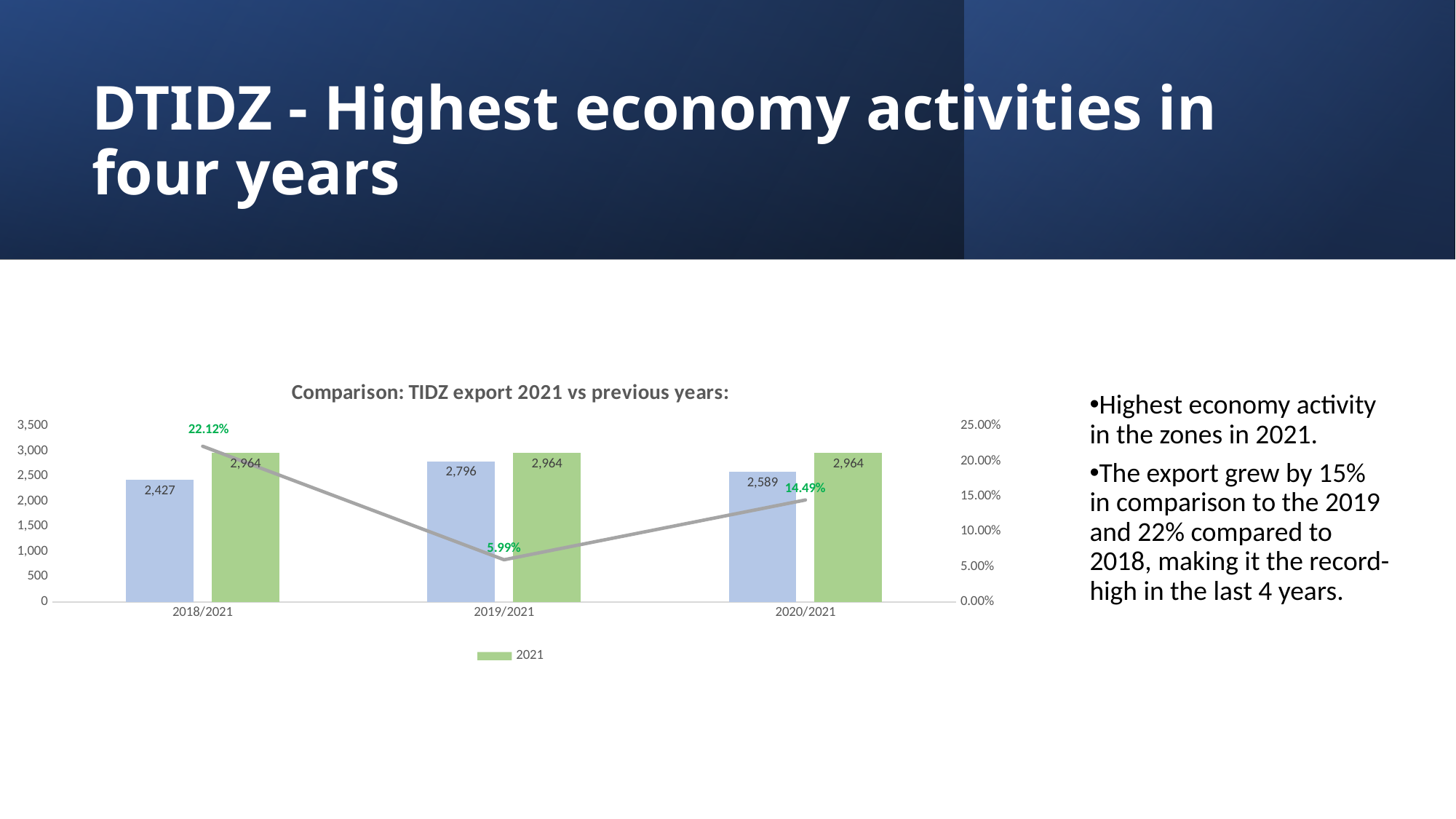
What is the title of the chart? Comparison: TIDZ export 2021 vs previous years: What is the value of the blue bar for 2018/2021? 2,427 What is the difference between the green 2021 bar and the blue bar for 2018/2021? 537 What percentage does the line show for 2019/2021? 5.99% What is the value of the green 2021 bar for 2019/2021? 2,964 What percentage does the line show for 2018/2021? 22.12% Which category has the lowest percentage on the line? 2019/2021 Which category has the highest blue bar value? 2019/2021 What percentage does the line show for 2020/2021? 14.49% How many categories are shown on the x axis? 3 What is the value of the blue bar for 2019/2021? 2,796 What is the value of the blue bar for 2020/2021? 2,589